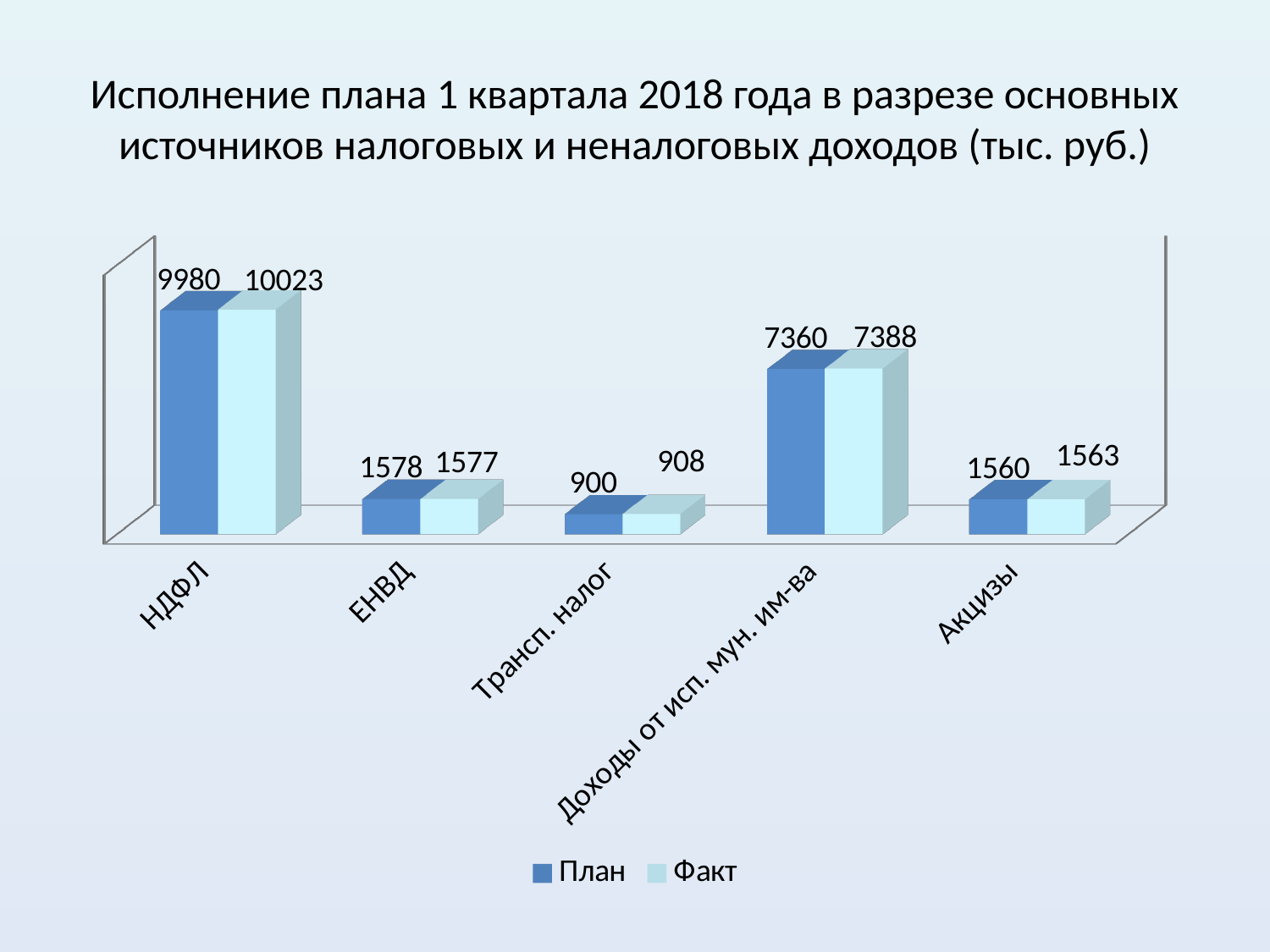
What is the План value for НДФЛ? 9980 What is the Факт value for Доходы от исп. мун. им-ва? 7388 How many categories are shown on the x axis? 5 What is the План value for Акцизы? 1560 How many series does the legend list? 2 Which is larger: the План value for ЕНВД or the План value for Доходы от исп. мун. им-ва? Доходы от исп. мун. им-ва What is the difference between the Факт and План values for Трансп. налог? 8 What kind of chart is shown on the slide? Bar chart What is the Факт value for Трансп. налог? 908 Which category has the highest Факт value? НДФЛ What is the difference between the Факт and План values for НДФЛ? 43 Which category has the lowest План value? Трансп. налог